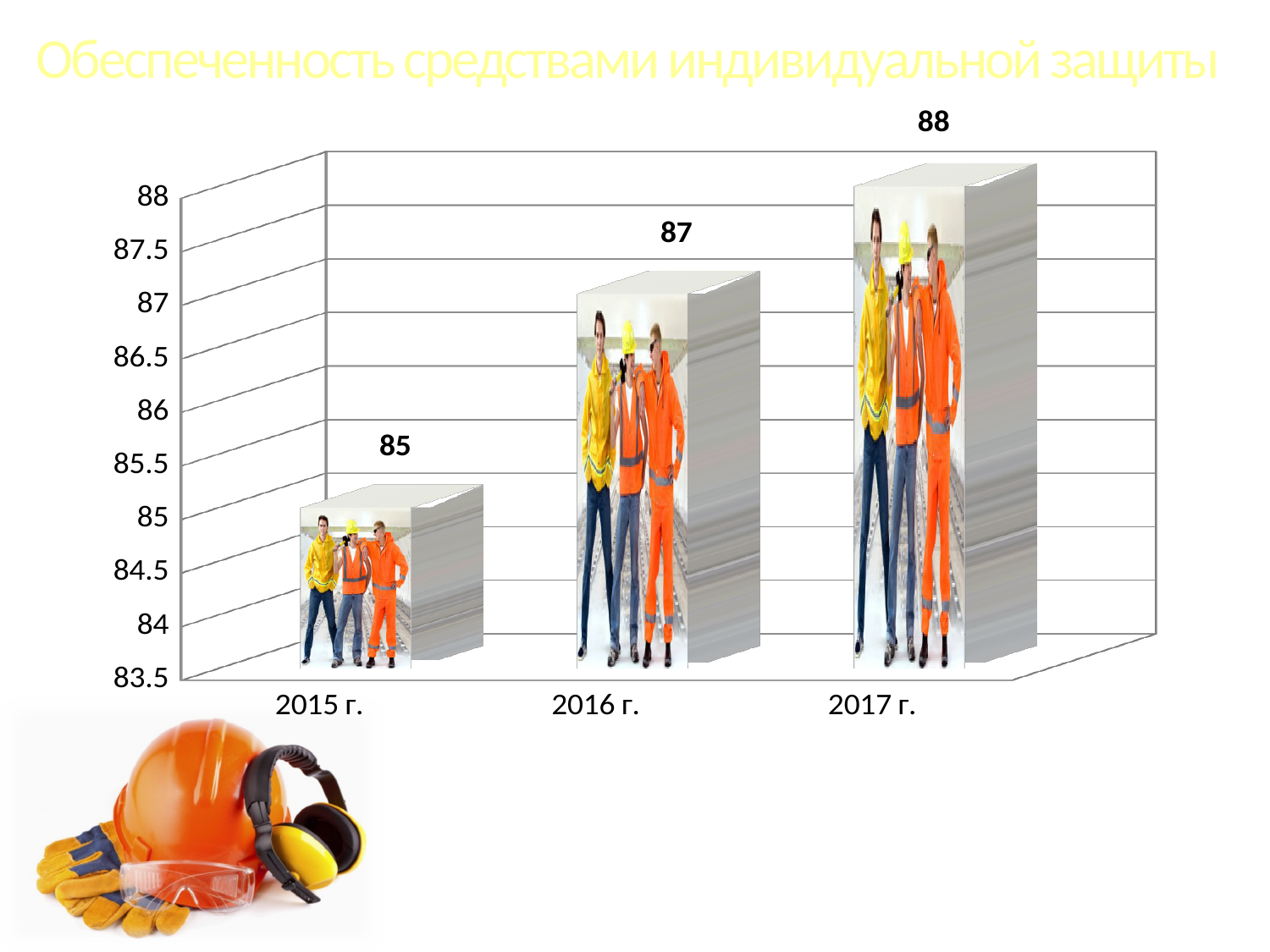
What is the value for 2017 г.? 88 Which year has the highest value? 2017 г. What is the difference between the values for 2016 г. and 2015 г.? 2 Is the value for 2015 г. greater or less than 86? less What is the value for 2016 г.? 87 Do the values rise or fall from 2015 г. to 2017 г.? rise How many years are shown on the chart? 3 What kind of chart is shown on the slide? bar chart What is the difference between the values for 2017 г. and 2015 г.? 3 Which is larger, the value for 2016 г. or the value for 2017 г.? 2017 г. What is the value for 2015 г.? 85 Which year has the lowest value? 2015 г.